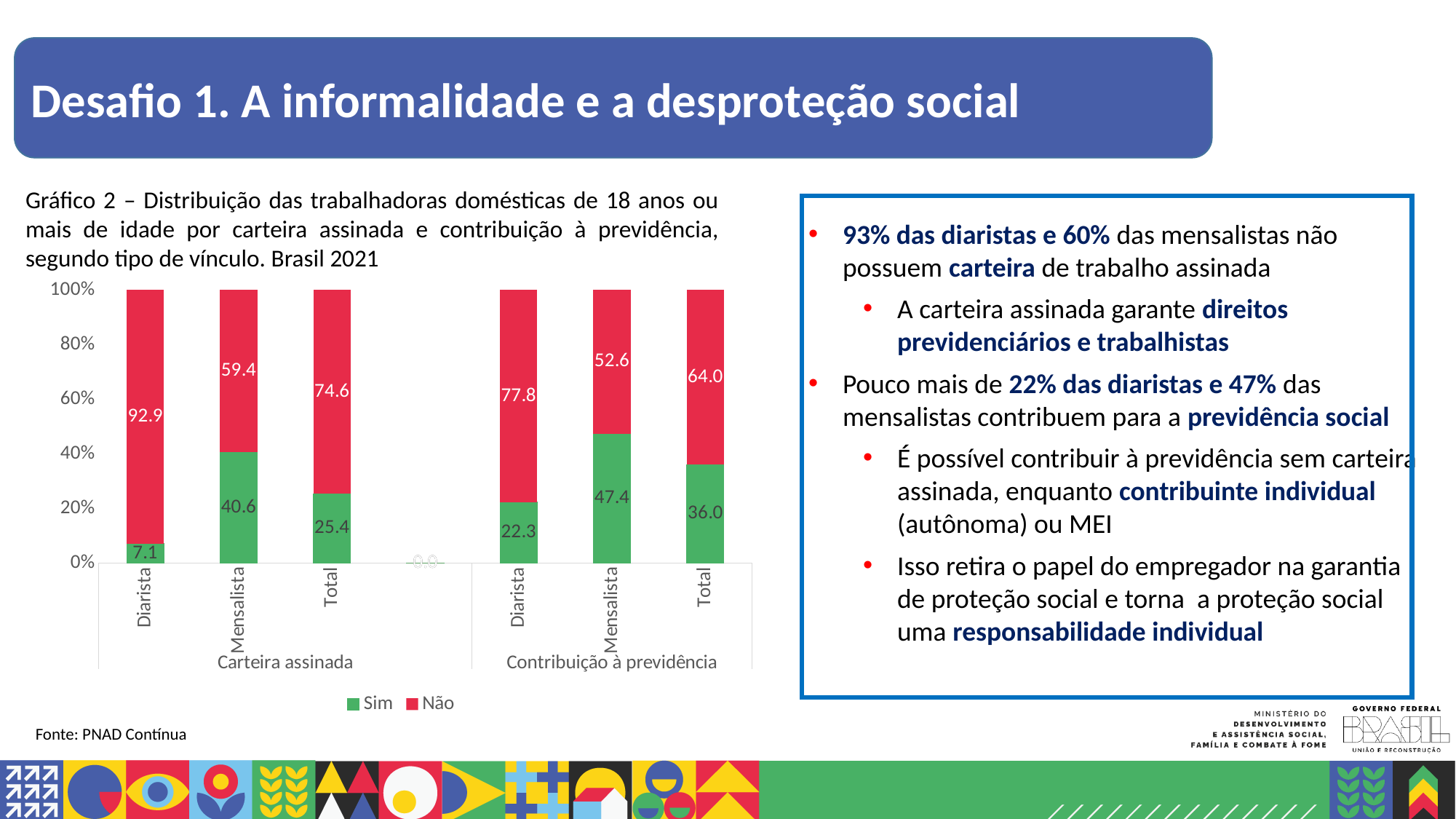
Which bar has the lowest 'Sim' value? Diarista (Carteira assinada) What type of chart is shown on the slide? Stacked bar chart Which is larger: the 'Sim' value for Mensalista under Carteira assinada or the 'Sim' value for Mensalista under Contribuição à previdência? Mensalista under Contribuição à previdência (47.4) What is the 'Não' value for Diarista under Contribuição à previdência? 77.8 Which bar has the highest 'Não' value? Diarista (Carteira assinada) Which colour represents the 'Não' series? Red What is the 'Sim' value for Total under Contribuição à previdência? 36.0 What is the difference between the 'Sim' values for Mensalista and Diarista under Carteira assinada? 33.5 How many series does the legend list? 2 How many bars are in the Carteira assinada group? 3 What is the 'Sim' value for Diarista under Carteira assinada? 7.1 What is the 'Não' value for Mensalista under Carteira assinada? 59.4